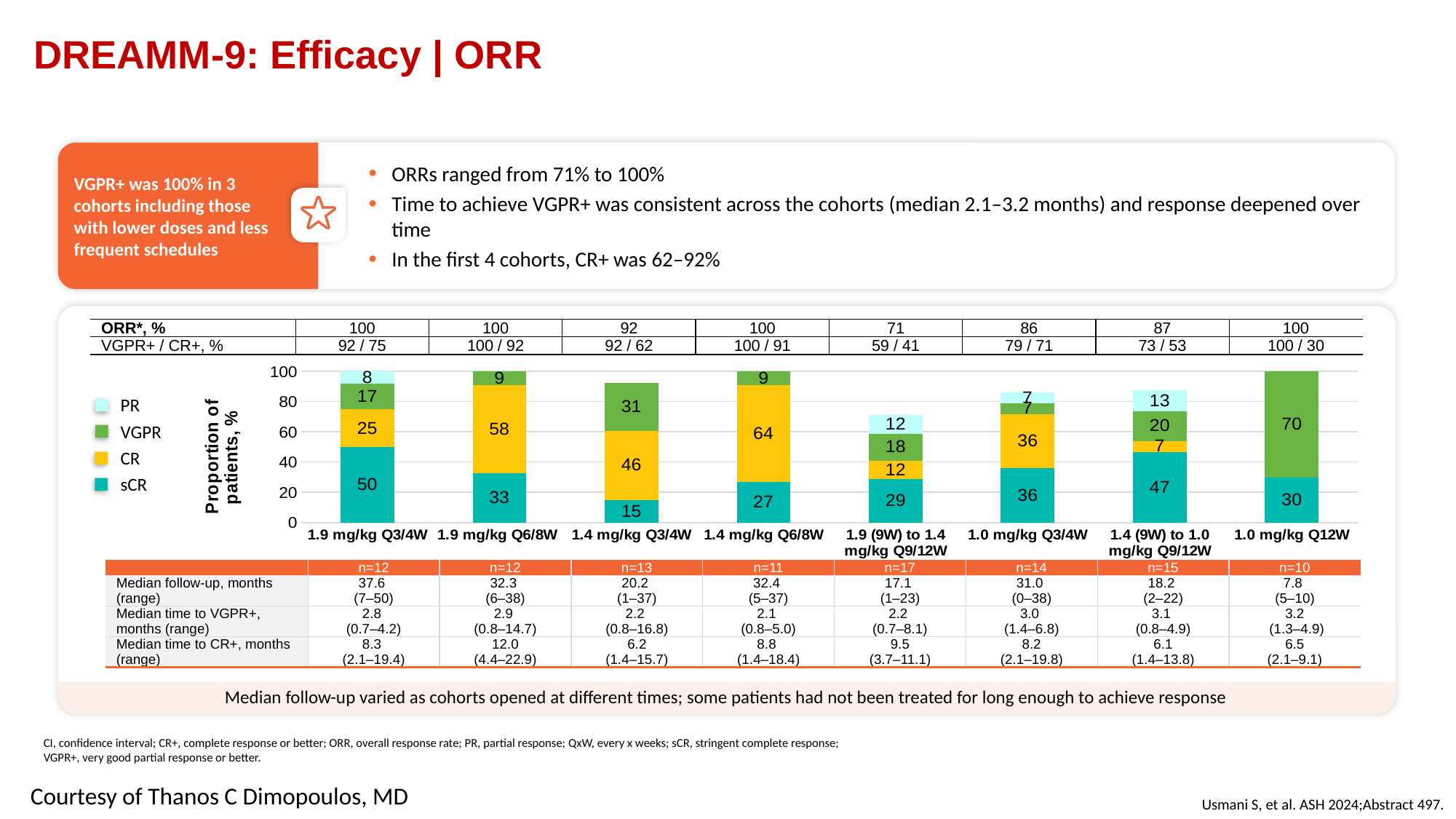
What is the CR value for the 1.4 mg/kg Q6/8W cohort? 64 What kind of chart is shown on the slide? Stacked bar chart What is the VGPR value for the 1.0 mg/kg Q12W cohort? 70 How many series does the chart legend list? 4 What is the total of the stacked bar for the 1.9 (9W) to 1.4 mg/kg Q9/12W cohort? 71 How many cohorts (bars) are plotted in the chart? 8 Which cohort has the highest sCR value? 1.9 mg/kg Q3/4W What is the sCR value for the 1.9 mg/kg Q3/4W cohort? 50 What is the difference between the CR values of the 1.9 mg/kg Q6/8W and 1.9 mg/kg Q3/4W cohorts? 33 What is the PR value for the 1.4 (9W) to 1.0 mg/kg Q9/12W cohort? 13 Which is larger, the VGPR value for the 1.4 mg/kg Q3/4W cohort or the VGPR value for the 1.4 (9W) to 1.0 mg/kg Q9/12W cohort? 1.4 mg/kg Q3/4W Which cohort has the lowest sCR value? 1.4 mg/kg Q3/4W